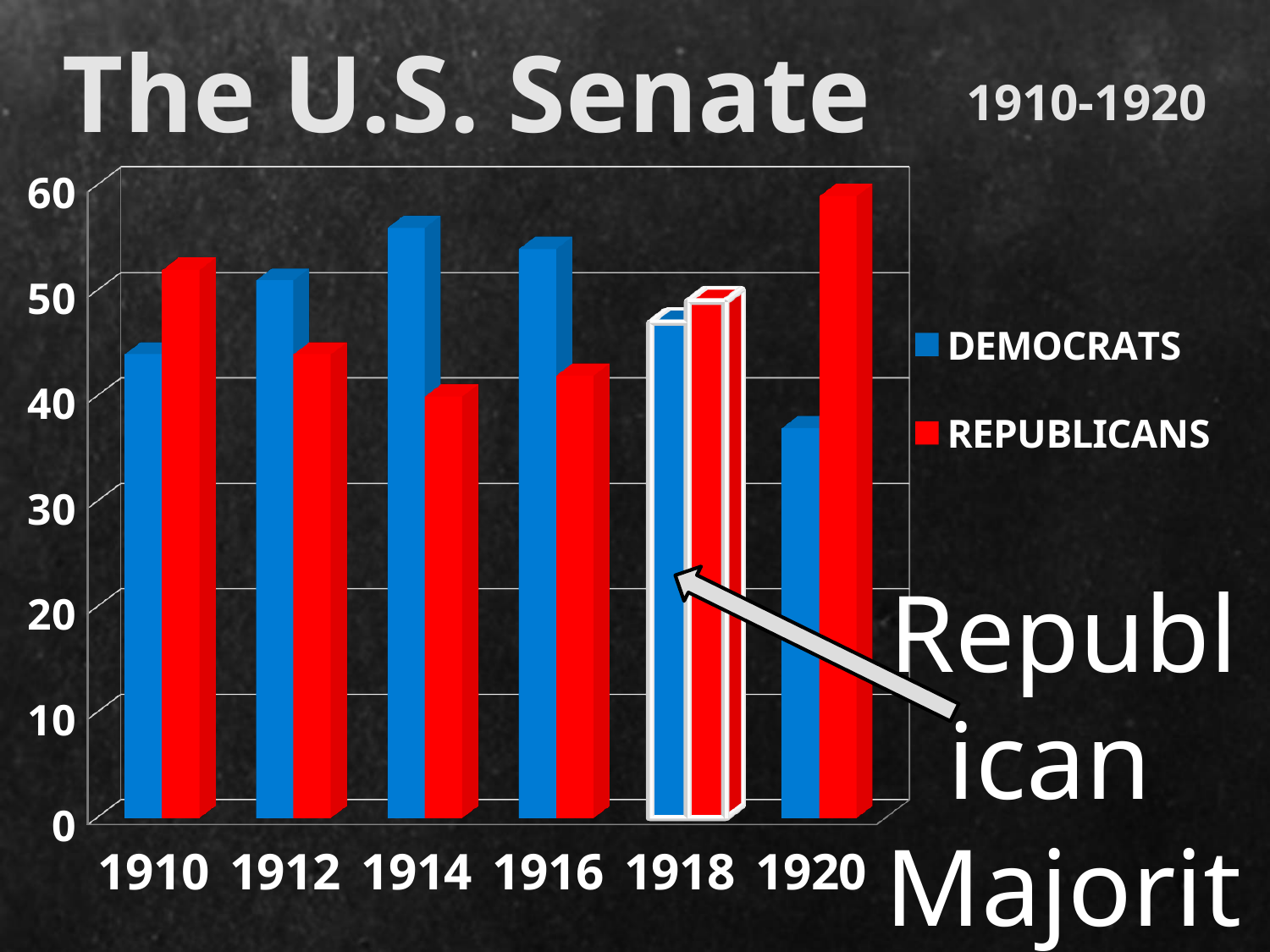
Is the value for Republicans in 1914 greater or less than 50? less In which year is the Republicans bar the highest? 1920 What kind of chart is shown on the slide? bar chart How many series does the chart's legend list? 2 What colour are the Democrats bars in the chart? blue In which year is the Democrats bar the lowest? 1920 Is the value for Republicans in 1920 greater or less than 50? greater In 1914, which is larger, the Democrats bar or the Republicans bar? Democrats Which two series are listed in the chart's legend? DEMOCRATS and REPUBLICANS Is the value for Democrats in 1910 greater or less than 50? less In 1920, which is larger, the Democrats bar or the Republicans bar? Republicans How many years are shown along the x axis of the chart? 6